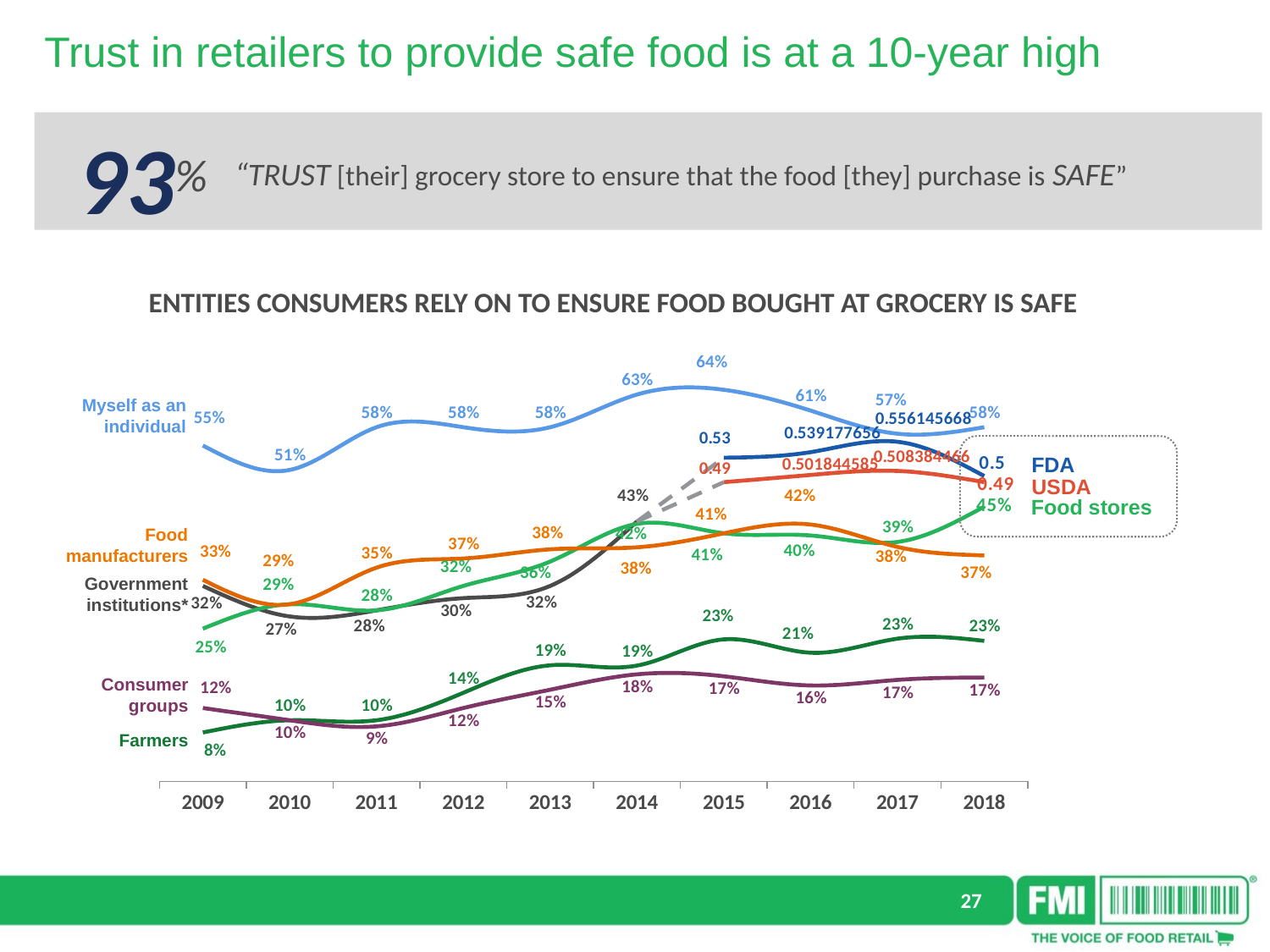
What is the title of the chart? ENTITIES CONSUMERS RELY ON TO ENSURE FOOD BOUGHT AT GROCERY IS SAFE What is the value for Farmers in 2009? 8% What is the value shown for FDA in 2018? 0.5 In which year does the Myself as an individual line reach its highest value? 2015 What kind of chart is shown on the slide? Line chart How many years are shown on the x axis? 10 What is the value for Food stores in 2018? 45% What is the value for Consumer groups in 2011? 9% In 2018, which is higher: Food manufacturers or Food stores? Food stores Does the Farmers line generally rise or fall from 2009 to 2018? Rise What is the value for Myself as an individual in 2015? 64% By how many percentage points did the Food stores value change from 2009 to 2018? 20 percentage points